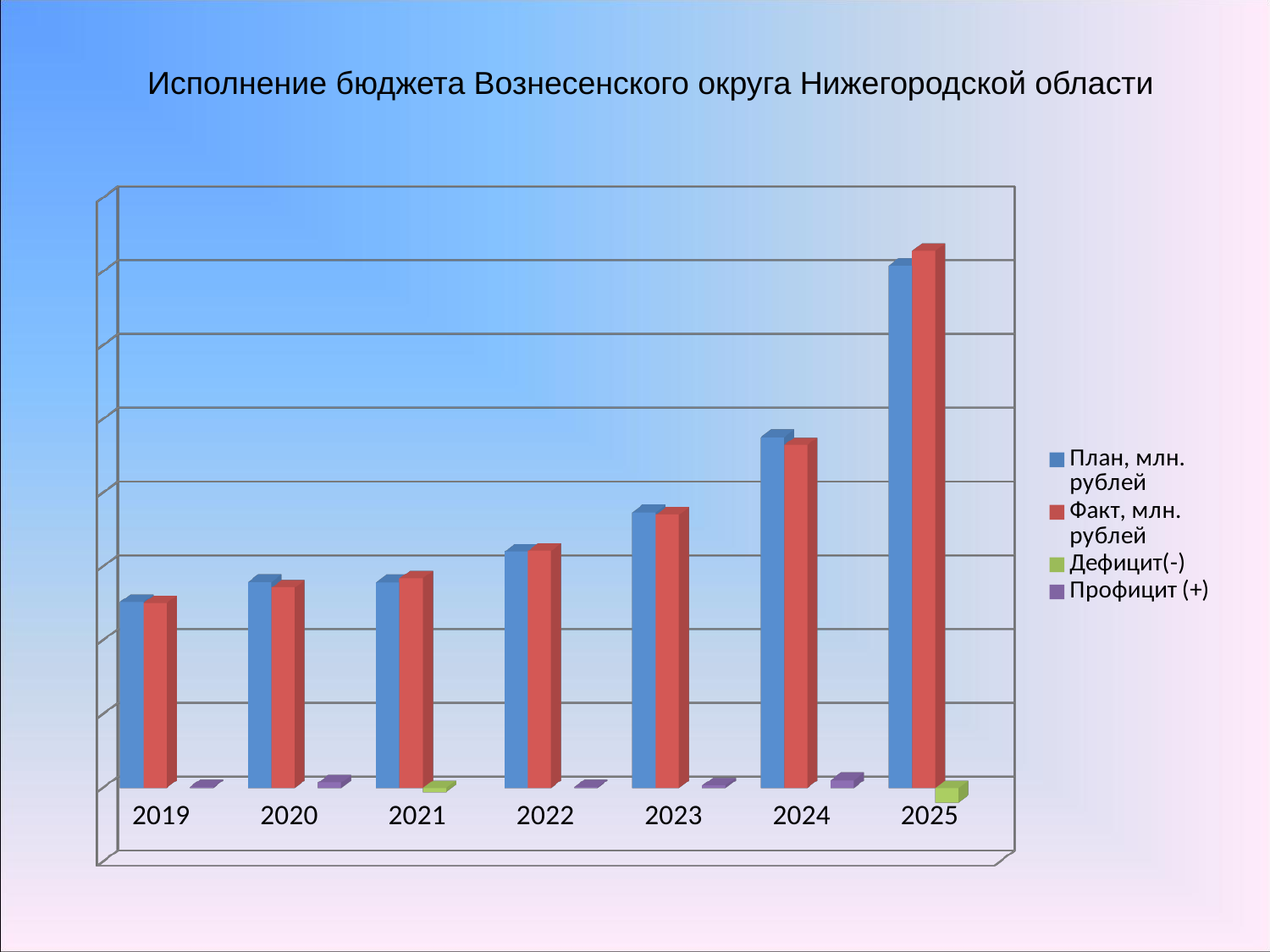
Is the План, млн. рублей value larger in 2025 or in 2024? 2025 How many series does the chart legend list? 4 Do the План, млн. рублей values generally rise or fall from 2019 to 2025? rise Is the Факт, млн. рублей value larger in 2019 or in 2023? 2023 How many years are shown on the x axis of the chart? 7 Which year has the highest value for Факт, млн. рублей? 2025 What kind of chart is shown on the slide? bar chart In which years does the chart show a Дефицит(-) bar? 2021 and 2025 Which year has the lowest value for Факт, млн. рублей? 2019 Which year has the highest value for План, млн. рублей? 2025 What is the title of the slide? Исполнение бюджета Вознесенского округа Нижегородской области